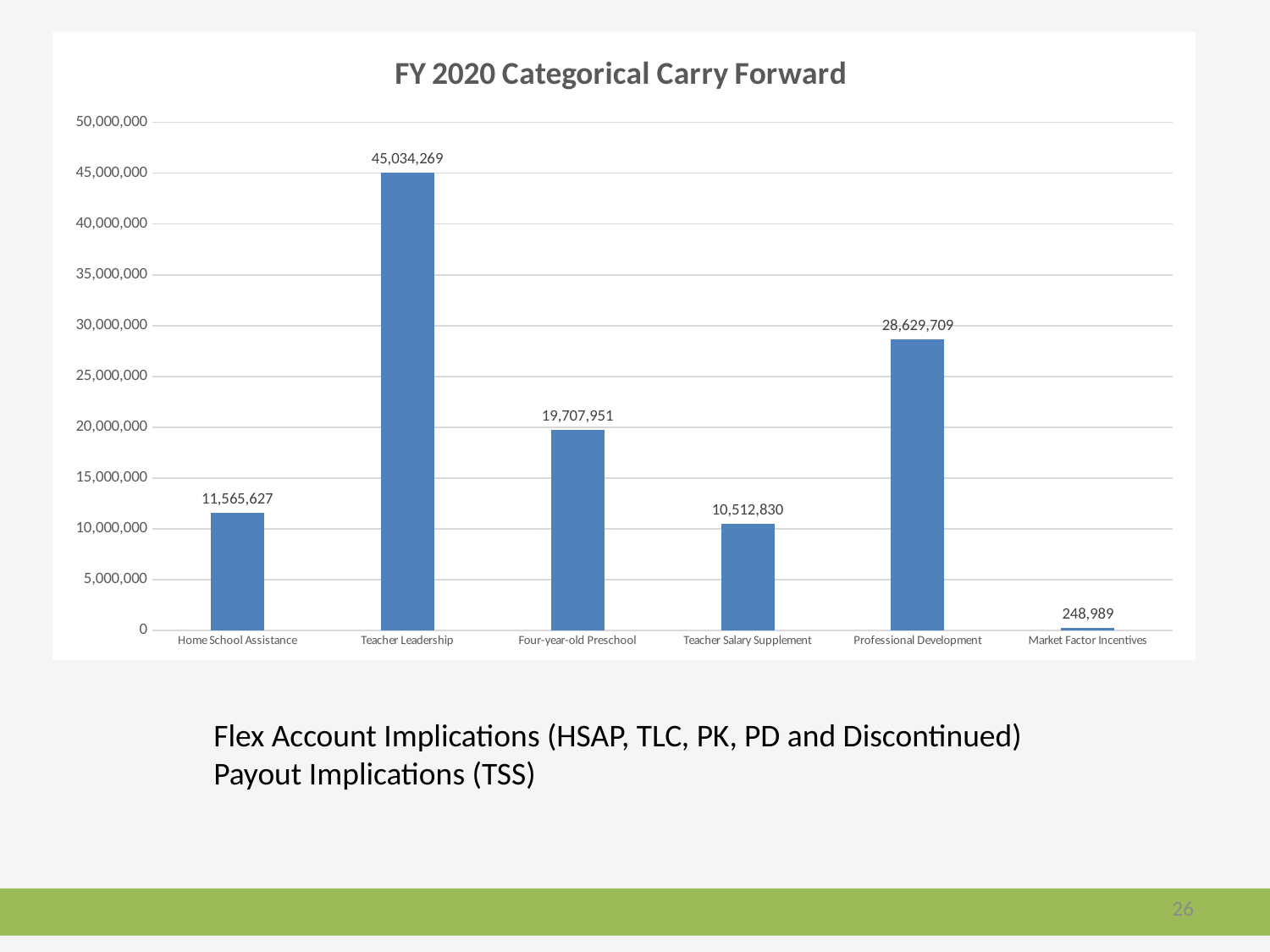
What type of chart is shown on the slide? Bar chart What is the value for Four-year-old Preschool? 19,707,951 Is the value for Professional Development greater or less than 25,000,000? greater Which is larger, Four-year-old Preschool or Home School Assistance? Four-year-old Preschool What is the difference between Home School Assistance and Teacher Salary Supplement? 1,052,797 What is the value for Professional Development? 28,629,709 What is the value for Teacher Leadership? 45,034,269 Which category has the lowest carry forward? Market Factor Incentives How many categories are shown on the chart? 6 What is the difference between Teacher Leadership and Professional Development? 16,404,560 Which category has the highest carry forward? Teacher Leadership What is the value for Market Factor Incentives? 248,989